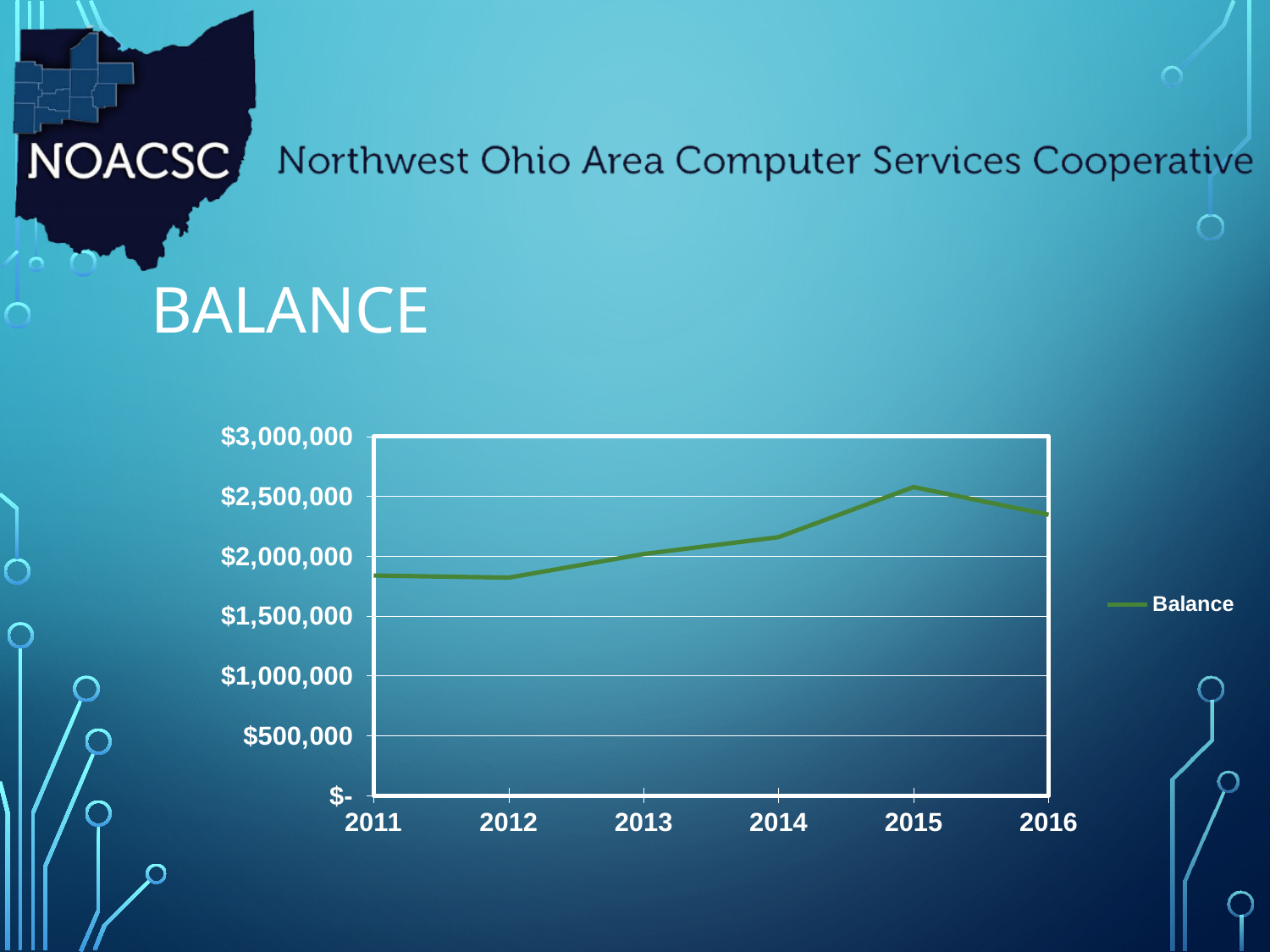
Does the balance rise or fall from 2012 to 2015? rise Is the balance for 2014 greater or less than $2,000,000? greater What is the name of the series shown in the chart's legend? Balance Is the balance for 2011 greater or less than $2,000,000? less Is the balance for 2016 greater or less than $2,500,000? less How many series does the chart's legend list? 1 How many years are plotted on the x axis of the chart? 6 In which year is the balance highest? 2015 What kind of chart is shown on the slide? line chart What is the title of the slide containing the chart? BALANCE Which year has the larger balance, 2015 or 2016? 2015